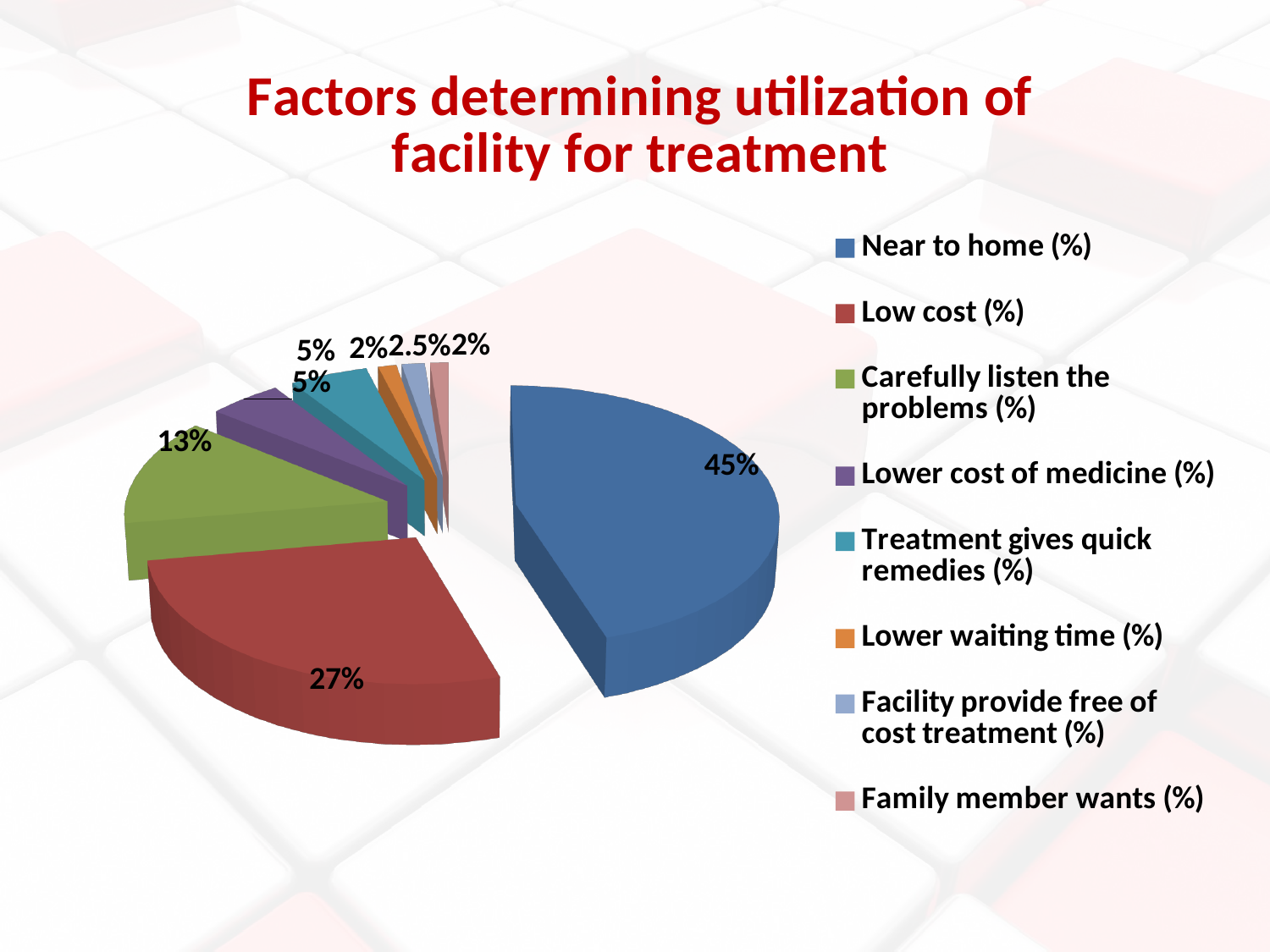
What value is shown for 'Carefully listen the problems (%)'? 13% What is the difference between the values for 'Near to home (%)' and 'Low cost (%)'? 18% Which category has the largest slice of the pie? Near to home (%) What value is shown for 'Facility provide free of cost treatment (%)'? 2.5% What value is shown for 'Low cost (%)'? 27% What kind of chart is shown on the slide? pie chart What is the combined share of 'Near to home (%)' and 'Low cost (%)'? 72% What is the title of the chart? Factors determining utilization of facility for treatment How many categories does the legend list? 8 Which is larger, 'Low cost (%)' or 'Carefully listen the problems (%)'? Low cost (%) What share of the pie is 'Near to home (%)'? 45% What colour is the slice for 'Near to home (%)'? blue